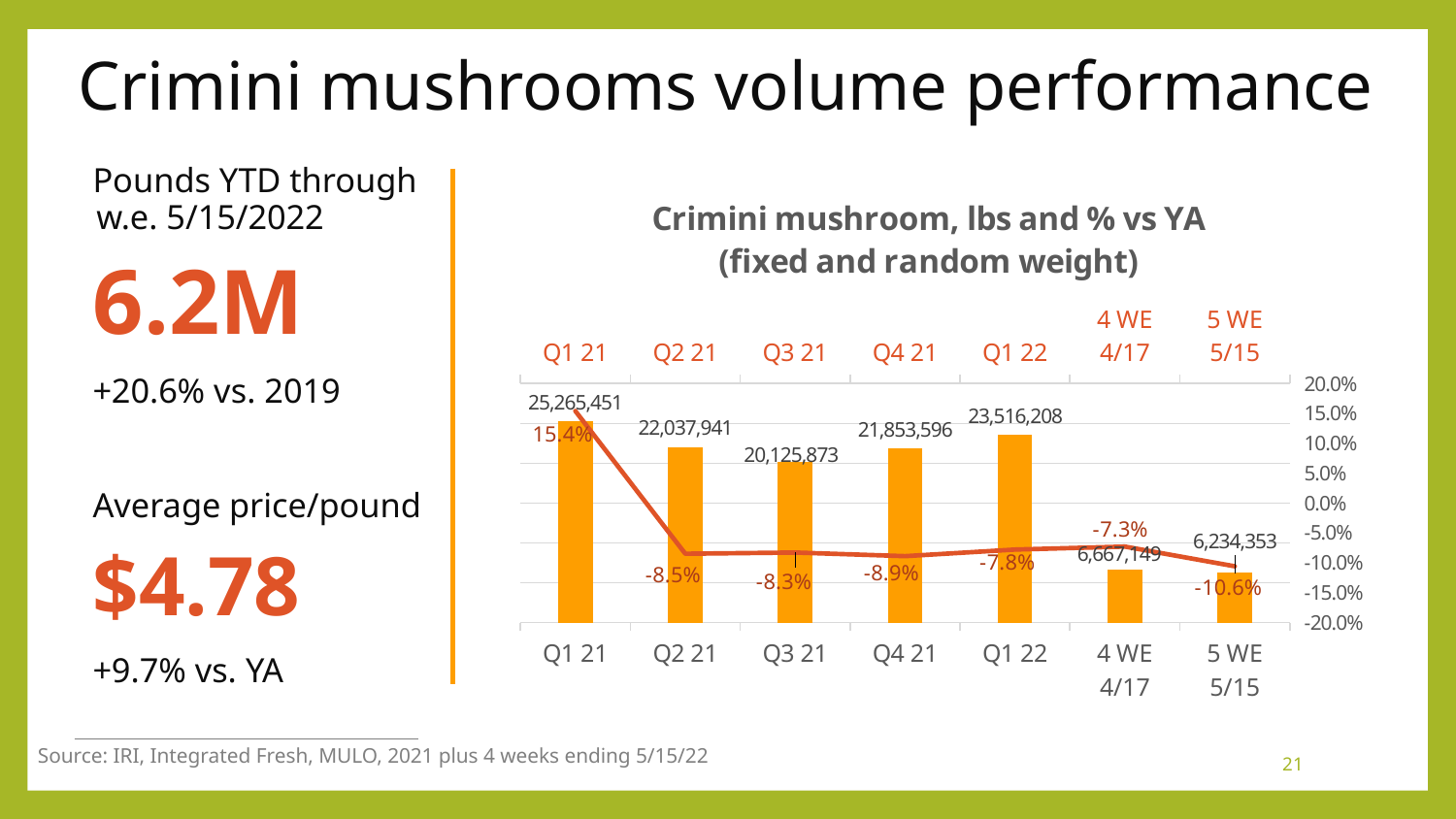
What is the pounds value for Q1 21? 25,265,451 What is the % vs YA value for the 5 WE 5/15 period? -10.6% What is the pounds value for Q1 22? 23,516,208 Which period has the highest pounds value? Q1 21 What is the title of the chart? Crimini mushroom, lbs and % vs YA (fixed and random weight) Which period has the lowest % vs YA value? 5 WE 5/15 Which period has the lowest pounds value? 5 WE 5/15 What kind of chart is this? Combination bar and line chart What is the % vs YA value for Q4 21? -8.9% Which is larger, the pounds value for Q3 21 or Q4 21? Q4 21 What is the difference in pounds between Q1 21 and Q2 21? 3,227,510 How many periods are shown on the x axis? 7